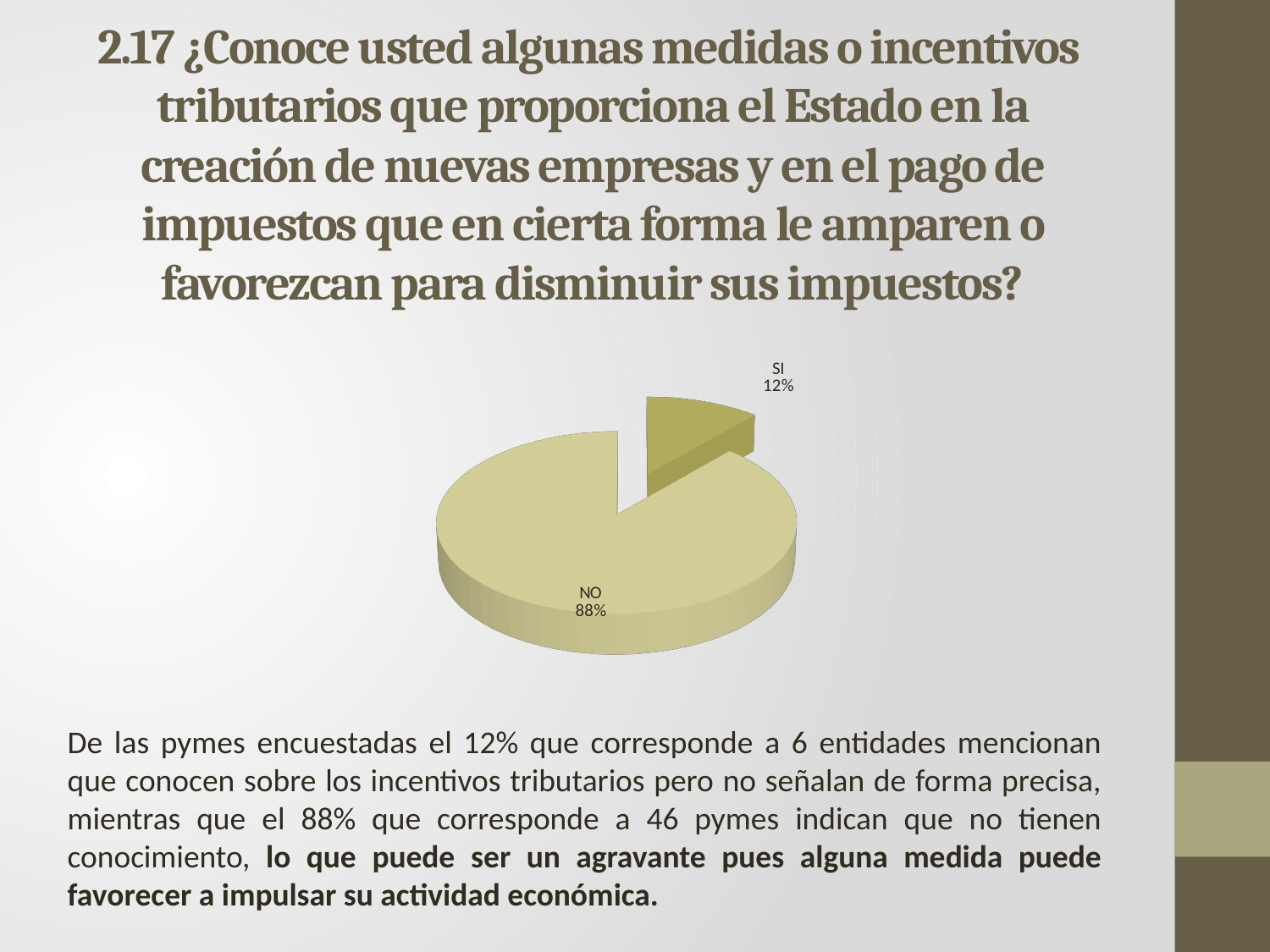
What type of chart is shown on the slide? Pie chart What are the labels of the two slices in the pie chart? SI and NO Which is larger in the pie chart, the "SI" slice or the "NO" slice? NO Which slice of the pie chart is the largest? NO What percentage of the pie chart corresponds to the "NO" slice? 88% What share of the pie does the "NO" slice represent? 88% What share of the pie does the "SI" slice represent? 12% Which slice of the pie chart is the smallest? SI What percentage of the pie chart corresponds to the "SI" slice? 12% How many slices does the pie chart have? 2 Which slice of the pie chart is pulled out (exploded) from the rest of the pie? SI What is the difference in percentage points between the "NO" slice and the "SI" slice? 76%